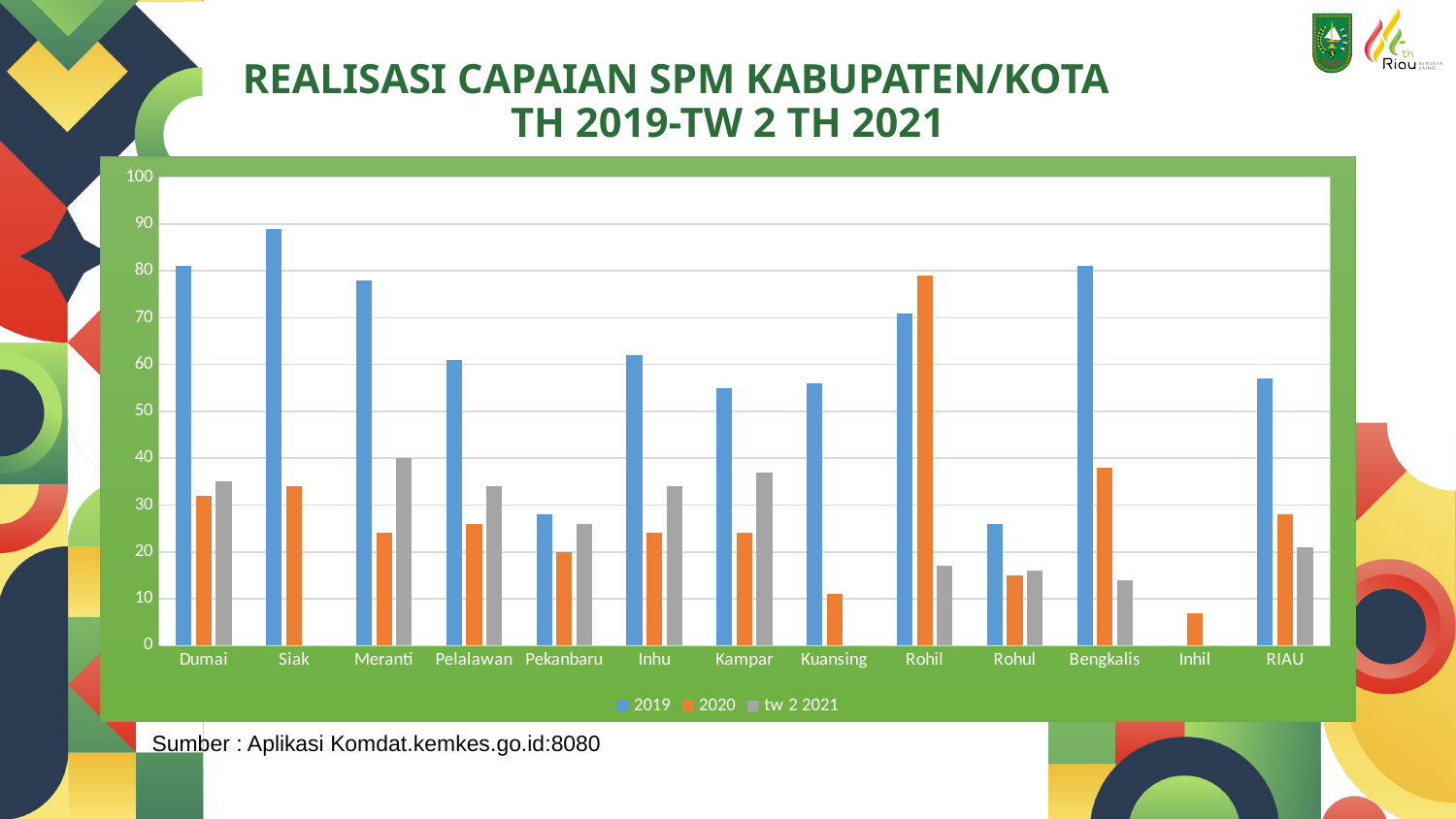
For Rohil, which series has the larger value, 2019 or 2020? 2020 Is the 2020 value for Inhil greater or less than 10? less Which category has the highest value for the 2020 series? Rohil Is the 2020 value for Kuansing greater or less than 20? less What kind of chart is shown on the slide? Bar chart Is the 2019 value for Siak greater or less than 80? greater Which category has the highest value for the 2019 series? Siak Which category has the highest value for the tw 2 2021 series? Meranti How many categories are shown along the x axis? 13 How many series does the legend list? 3 What are the three entries in the chart legend? 2019, 2020, tw 2 2021